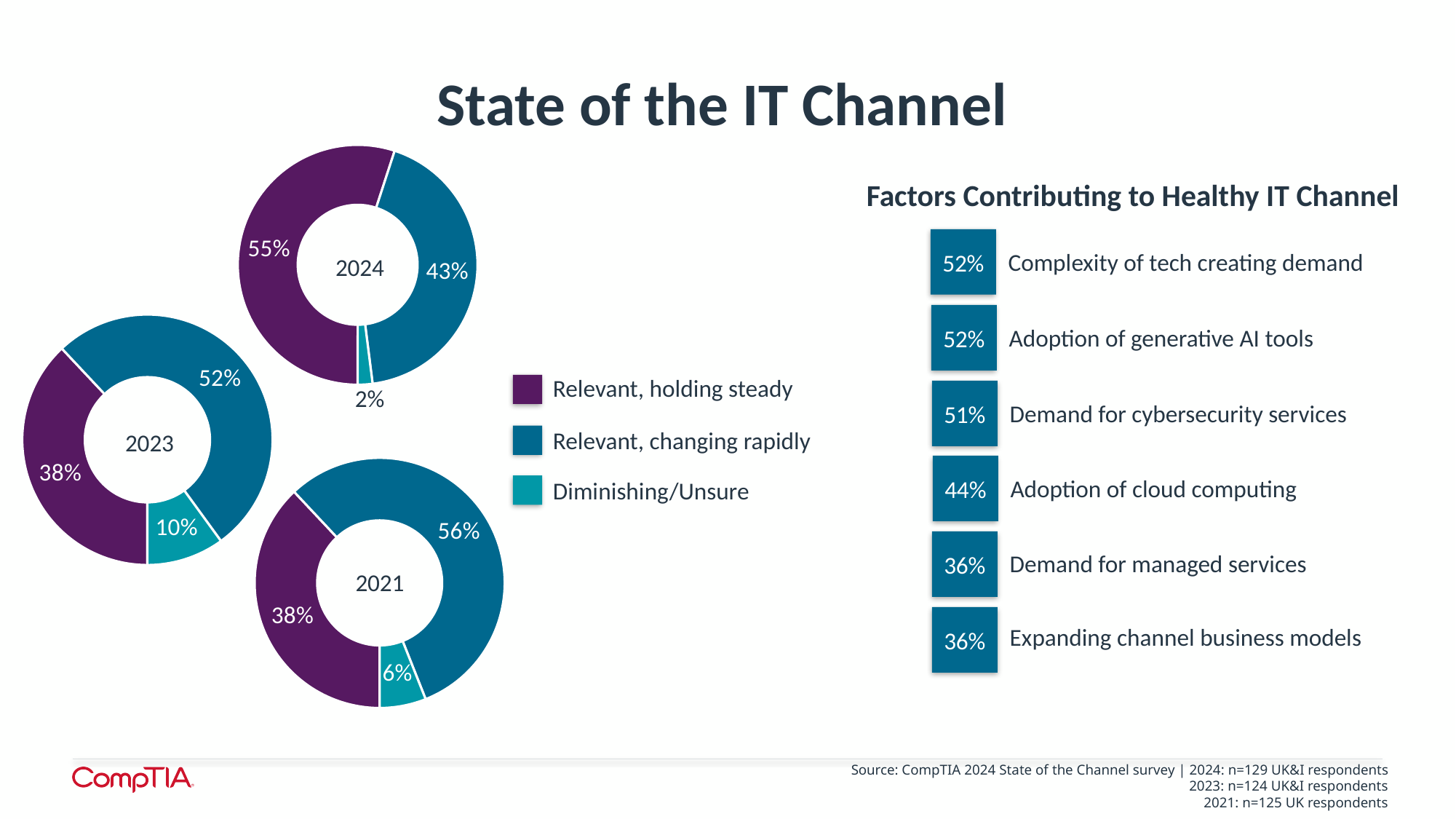
In the 'Factors Contributing to Healthy IT Channel' list, what percentage is shown for 'Adoption of cloud computing'? 44% Which is larger in the 2023 donut chart: 'Relevant, holding steady' or 'Relevant, changing rapidly'? Relevant, changing rapidly How does the 'Diminishing/Unsure' share change from 2023 to 2024? It falls from 10% to 2% In the 2023 donut chart, what share of respondents said the IT channel is 'Relevant, changing rapidly'? 52% In the 2024 donut chart, which category has the smallest share? Diminishing/Unsure What type of chart is used to show the 2024, 2023 and 2021 results? Donut chart Which colour represents 'Relevant, holding steady' in the donut charts? Purple In the 2024 donut chart, what share of respondents said the IT channel is 'Relevant, holding steady'? 55% In the 2024 donut chart, what is the difference between the 'Relevant, holding steady' share and the 'Relevant, changing rapidly' share? 12% How many entries does the legend for the donut charts list? 3 In the 2021 donut chart, which category has the largest share? Relevant, changing rapidly In the 2021 donut chart, what share of respondents answered 'Diminishing/Unsure'? 6%